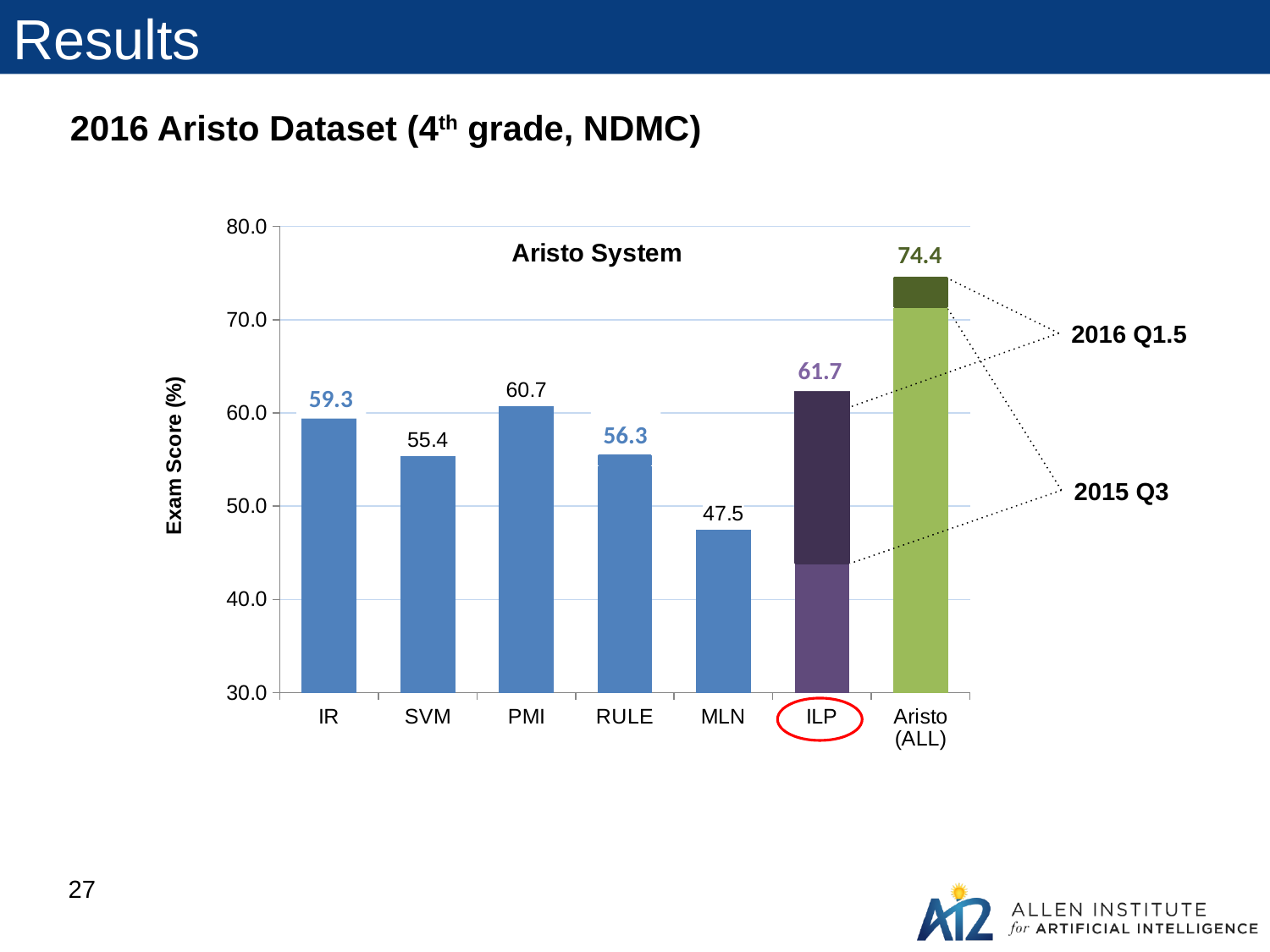
Which system has the highest exam score? Aristo (ALL) What is the exam score for RULE? 56.3 What type of chart is shown on the slide? bar chart What is the difference between the exam scores of Aristo (ALL) and ILP? 12.7 What is the exam score for IR? 59.3 Which has a higher exam score, PMI or SVM? PMI What is the exam score for Aristo (ALL)? 74.4 Which system has the lowest exam score? MLN What is the label of the y axis? Exam Score (%) Is the exam score for MLN greater or less than 50.0? less How many systems are shown on the x axis? 7 What is the exam score for MLN? 47.5